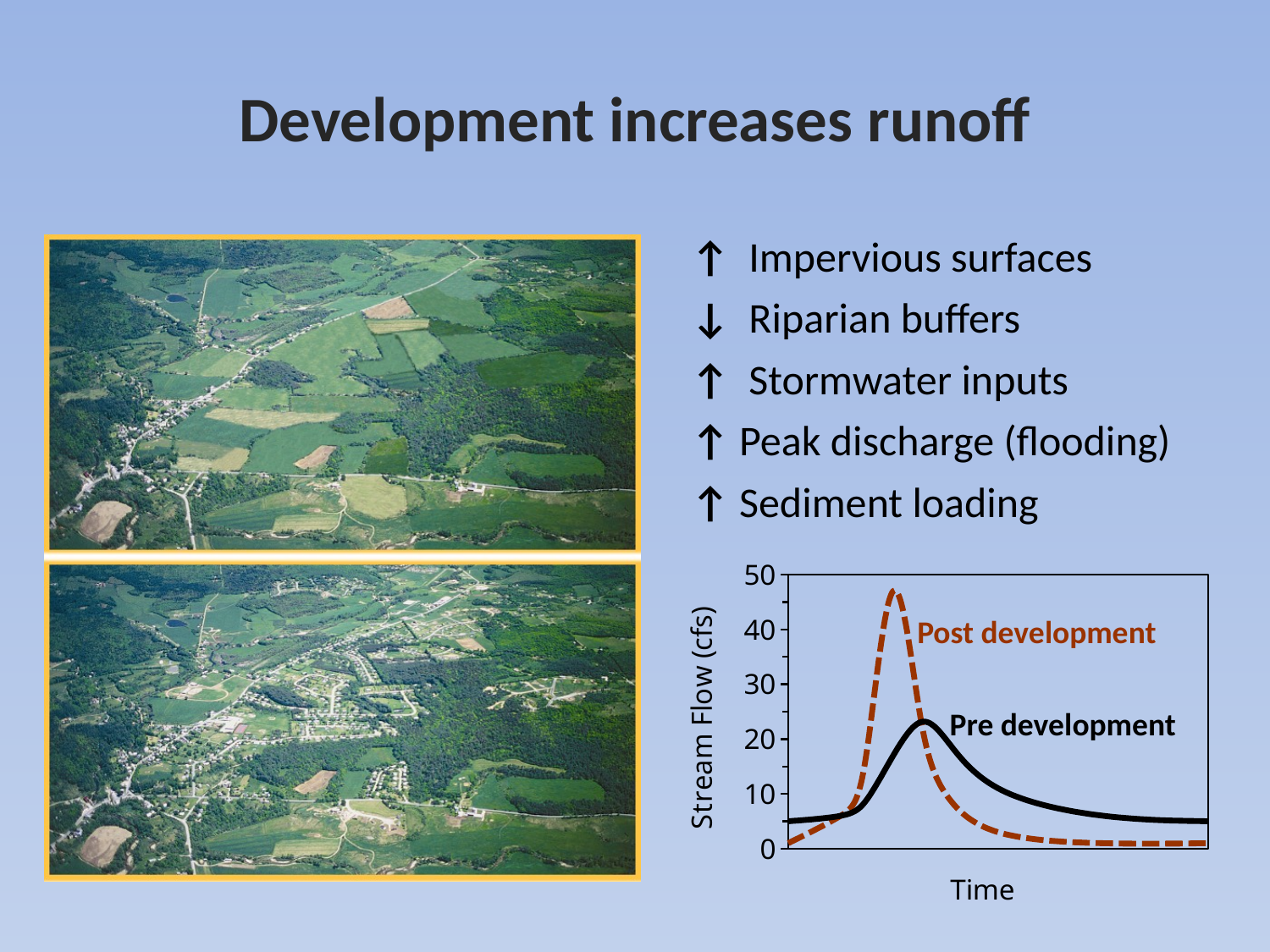
What is the label of the horizontal axis on the stream flow chart? Time What kind of chart is shown at the bottom right of the slide? line chart Which series reaches the higher peak stream flow, Post development or Pre development? Post development Is the peak value of the Pre development series greater or less than 30? less What is the label of the vertical axis on the stream flow chart? Stream Flow (cfs) Is the peak value of the Post development series greater or less than 50? less What is the highest tick value shown on the vertical axis of the stream flow chart? 50 After its peak, does the Post development stream flow rise or fall over time? fall Is the peak value of the Post development series greater or less than 40? greater Which series has the lower peak stream flow? Pre development How many series are plotted on the stream flow chart? 2